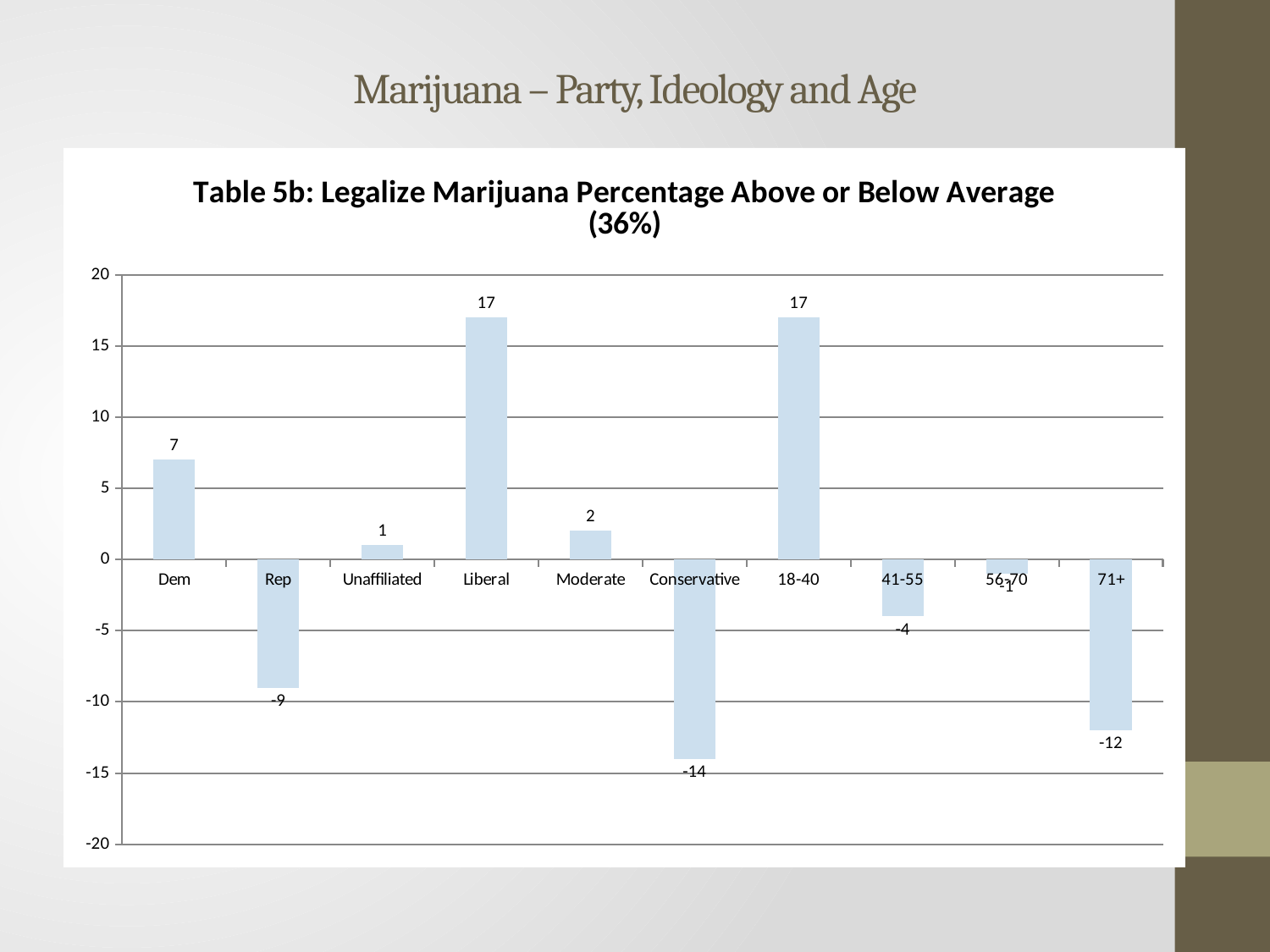
What is the value for Moderate? 2 Which is larger, the value for Dem or the value for Unaffiliated? Dem What is the value for Conservative? -14 What kind of chart is this? Bar chart What is the difference between the values for Liberal and Dem? 10 Which category has the lowest value? Conservative How many categories are shown on the x axis? 10 What is the difference between the values for Rep and Conservative? 5 Which is lower, the value for 41-55 or the value for 71+? 71+ What average percentage is stated in the chart title? 36% What is the value for Dem? 7 What is the value for 71+? -12